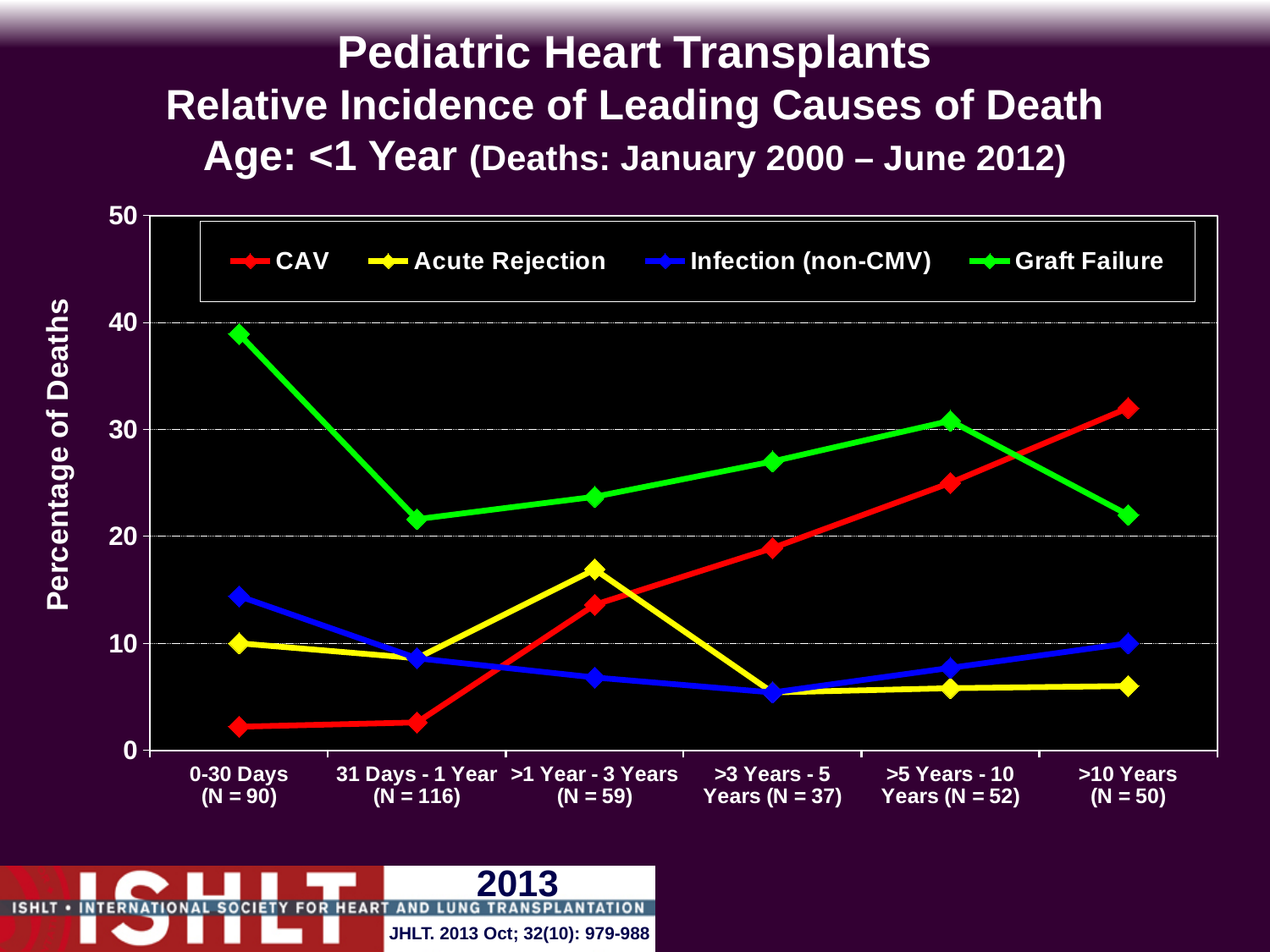
Is the value for CAV at >10 Years greater or less than 30? greater What colour is the Graft Failure line? green Is the value for CAV at 0-30 Days greater or less than 10? less Which cause of death has the highest percentage at >10 Years? CAV Is the value for Graft Failure at 0-30 Days greater or less than 30? greater At >1 Year - 3 Years, which is larger: Acute Rejection or Infection (non-CMV)? Acute Rejection How many series does the legend list? 4 How many time-period categories are shown on the x axis? 6 What kind of chart is shown on the slide? line chart Does the CAV line rise or fall across the time periods from 0-30 Days to >10 Years? rises Which cause of death has the highest percentage at 0-30 Days? Graft Failure Which cause of death has the lowest percentage at 0-30 Days? CAV